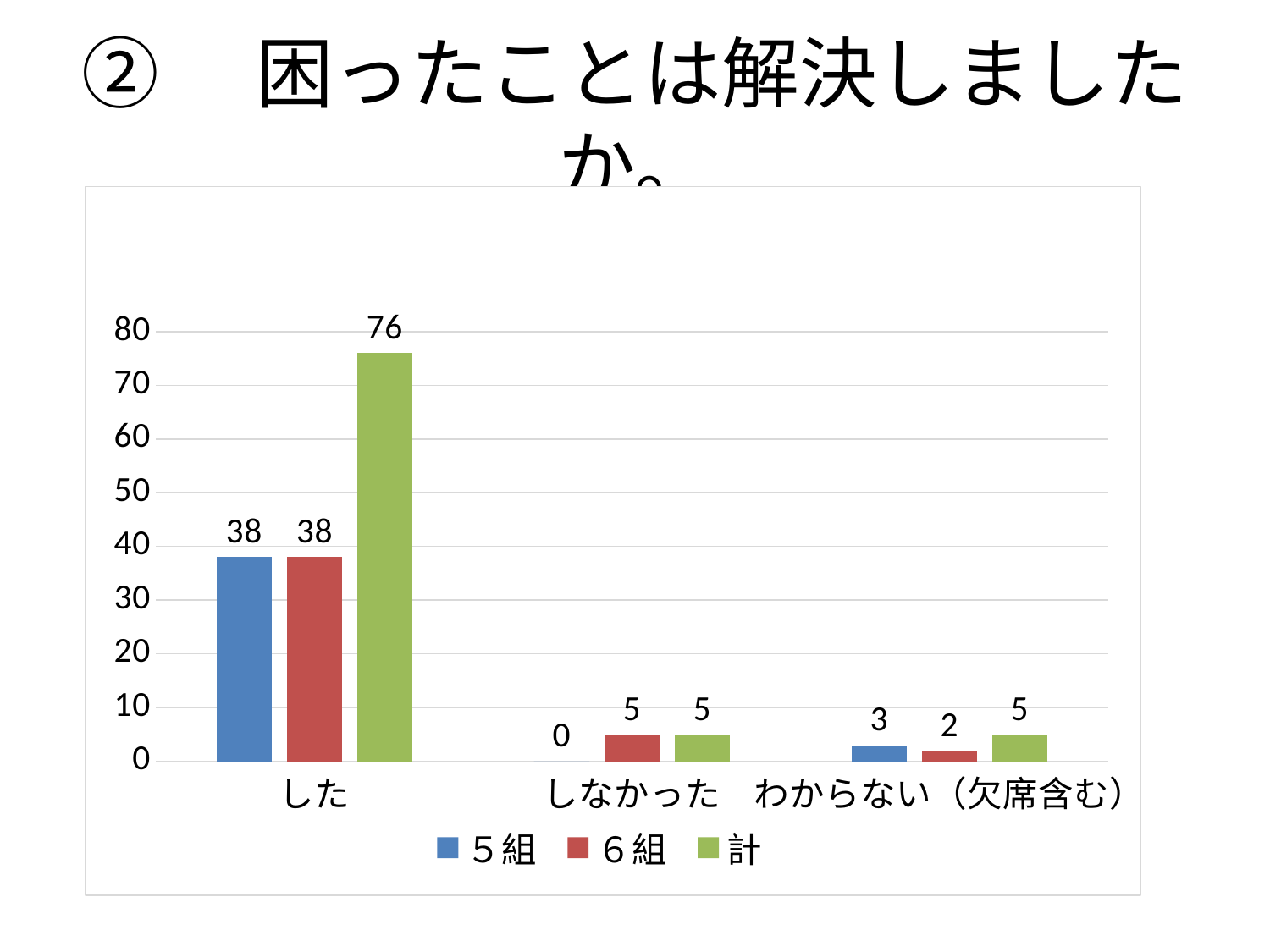
What kind of chart is shown on the slide? bar chart What is the value for 計 in the した category? 76 What is the value for 6組 in the しなかった category? 5 What is the difference between the 計 value for した and the 計 value for しなかった? 71 Which category has the lowest value for 5組? しなかった Which category has the highest value for 計? した What is the value for 6組 in the わからない（欠席含む） category? 2 How many series does the legend list? 3 What is the value for 5組 in the した category? 38 Which is larger: the 5組 value or the 6組 value in the わからない（欠席含む） category? 5組 What is the value for 5組 in the わからない（欠席含む） category? 3 How many categories are shown on the x axis? 3